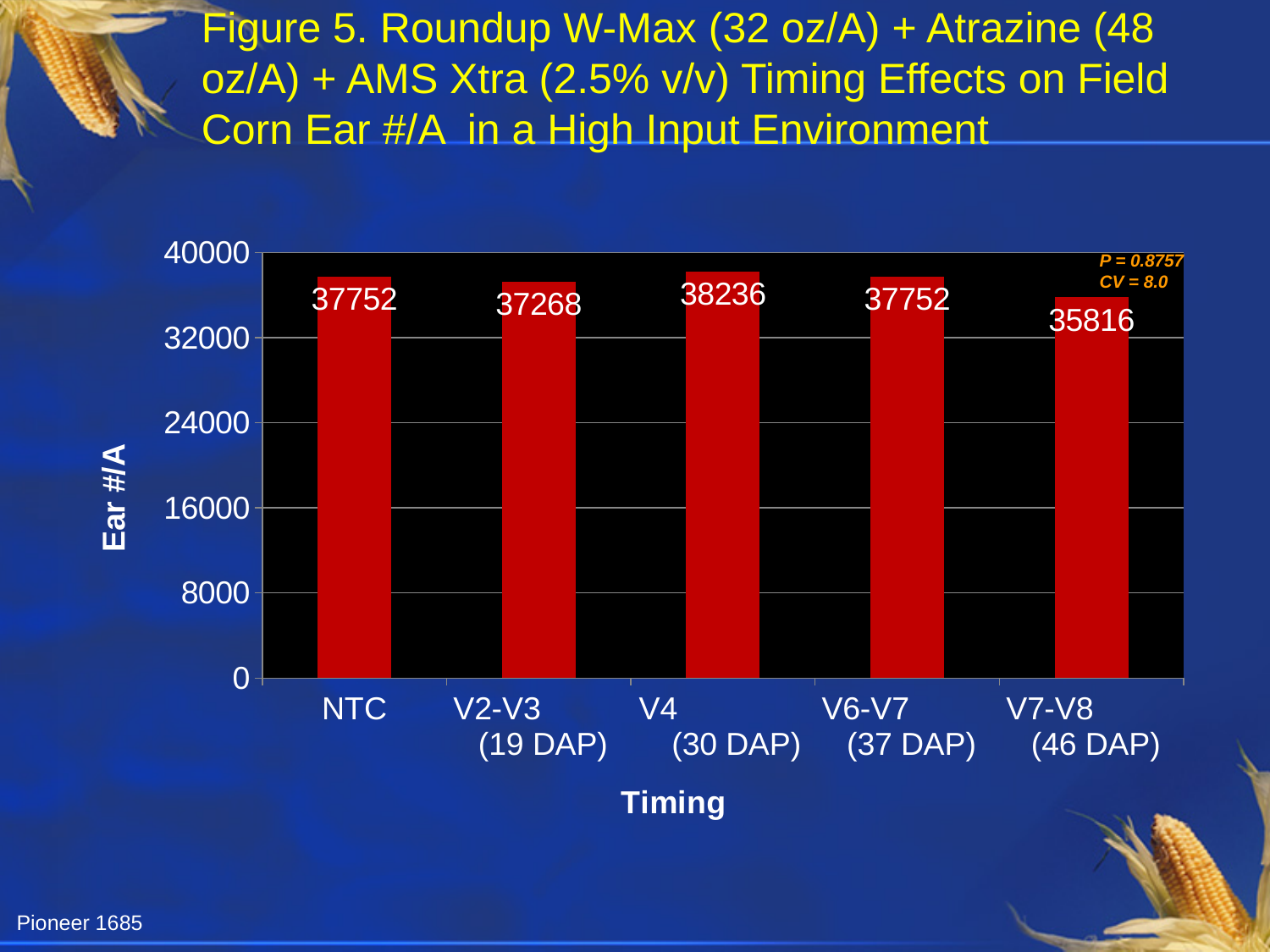
Which timing has the highest Ear #/A? V4 (30 DAP) What is the Ear #/A value for the NTC timing? 37752 Which timing has the lowest Ear #/A? V7-V8 (46 DAP) What is the P value shown on the chart? P = 0.8757 Which has a larger Ear #/A, V2-V3 (19 DAP) or V6-V7 (37 DAP)? V6-V7 (37 DAP) What kind of chart is shown on the slide? bar chart What is the Ear #/A value for the V7-V8 (46 DAP) timing? 35816 Is the Ear #/A value for V7-V8 (46 DAP) greater or less than 32000? greater How many timing categories are shown on the x axis? 5 What is the difference in Ear #/A between the V4 (30 DAP) and V7-V8 (46 DAP) timings? 2420 What is the Ear #/A value for the V4 (30 DAP) timing? 38236 What is the Ear #/A value for the V2-V3 (19 DAP) timing? 37268